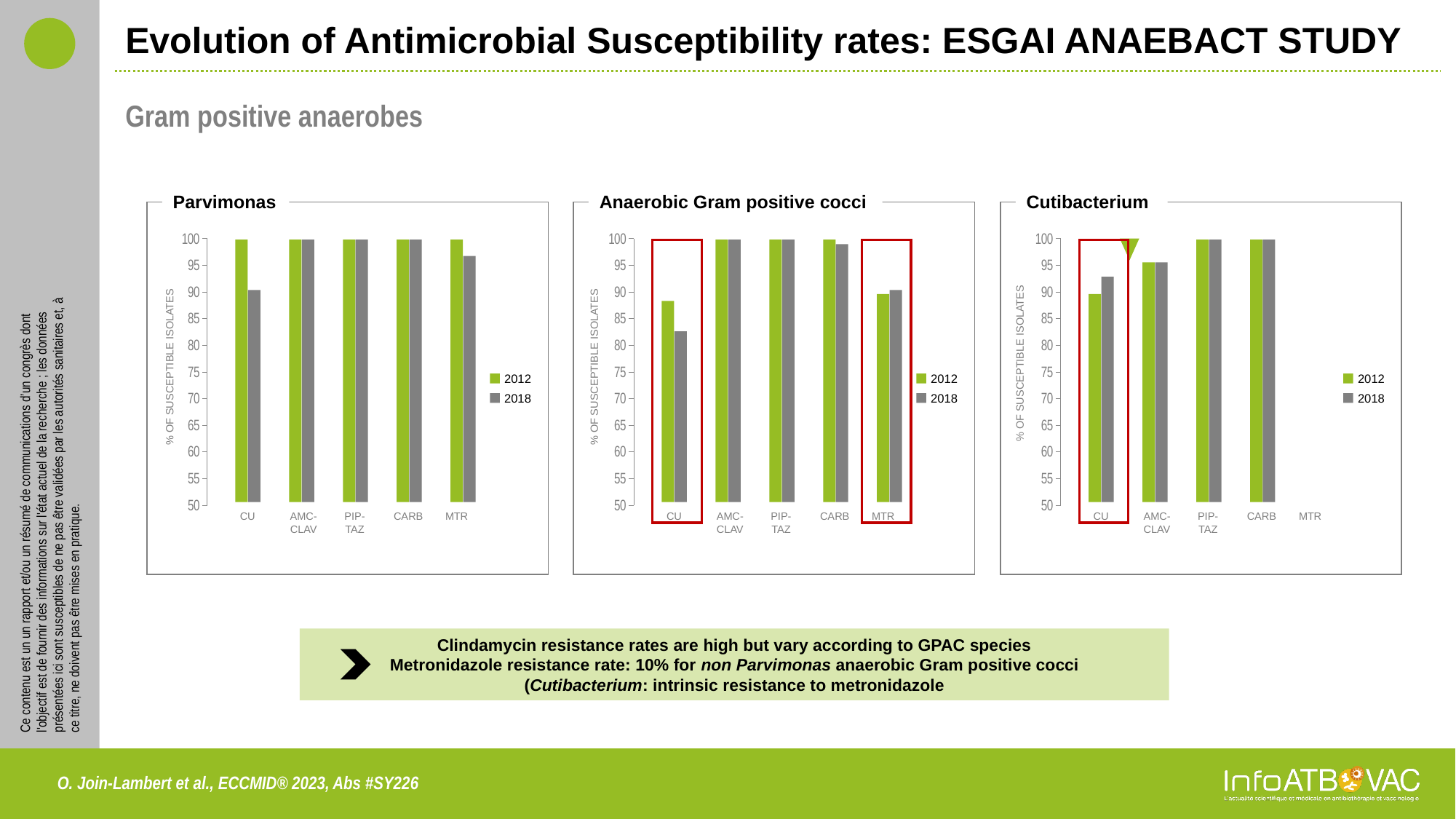
In the Cutibacterium chart, which x-axis category has no bars plotted? MTR What type of chart is used for the Parvimonas panel? bar chart In the Cutibacterium chart, which is larger for CU, the 2012 value or the 2018 value? 2018 In the Parvimonas chart, how many series does the legend list? 2 What is the y-axis label of the Anaerobic Gram positive cocci chart? % OF SUSCEPTIBLE ISOLATES In the Parvimonas chart, is the 2018 value for CU greater or less than 95? less In the Cutibacterium chart, is the 2012 value for AMC-CLAV greater or less than 90? greater In the Parvimonas chart, which category has the lowest 2018 value? CU In the Parvimonas chart, how many antibiotic categories are shown on the x axis? 5 In the Anaerobic Gram positive cocci chart, is the 2018 value for CU greater or less than 85? less In the Anaerobic Gram positive cocci chart, which category has the lowest 2018 value? CU In the Anaerobic Gram positive cocci chart, which is larger for CU, the 2012 value or the 2018 value? 2012